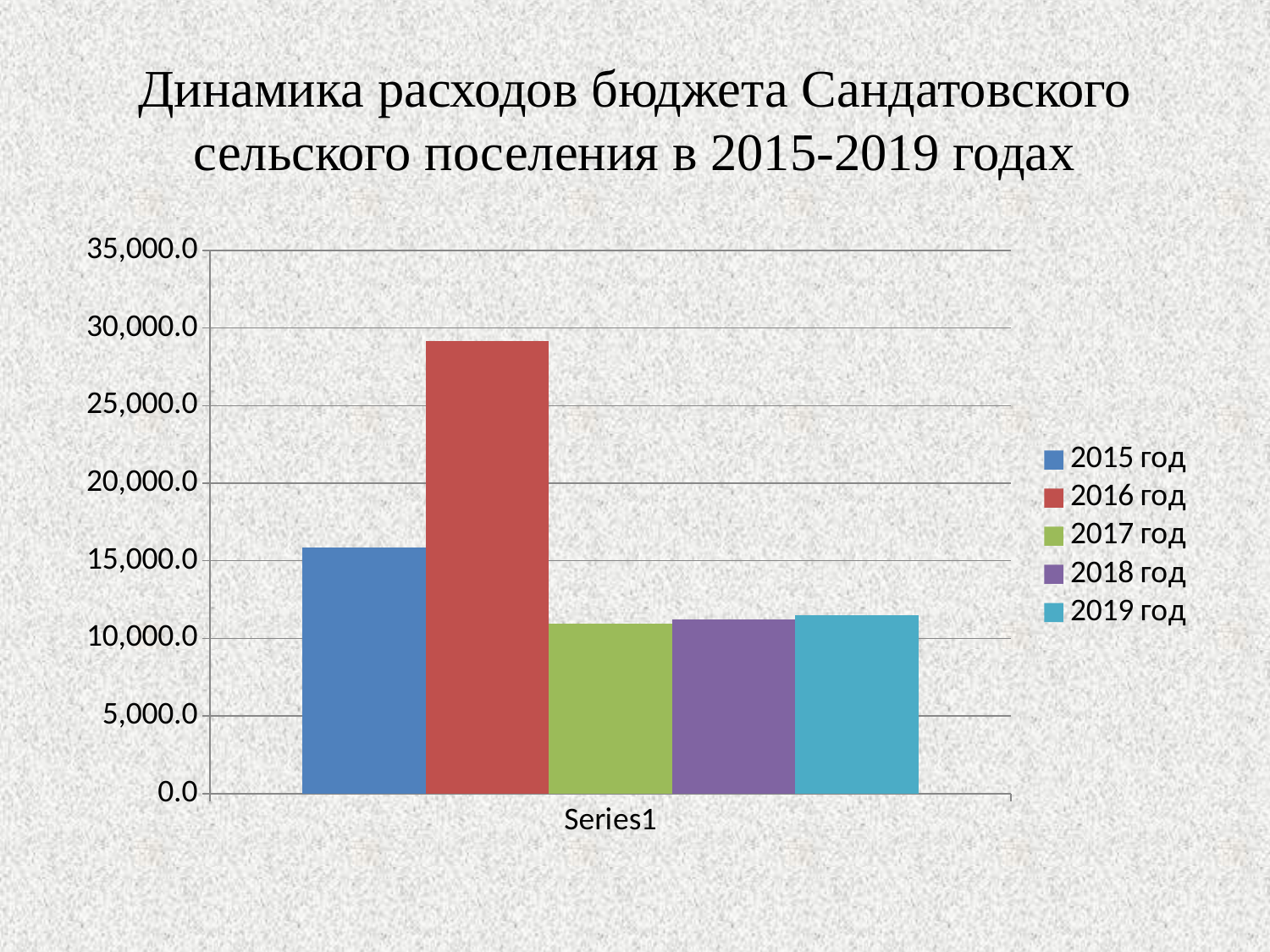
Which year has the highest bar? 2016 год What kind of chart is shown on the slide? bar chart Which is larger, the value for 2015 год or the value for 2016 год? 2016 год Which is larger, the value for 2015 год or the value for 2019 год? 2015 год Is the value for 2016 год greater or less than 25,000.0? greater Is the value for 2017 год greater or less than 15,000.0? less How many series does the legend list? 5 Is the value for 2015 год greater or less than 15,000.0? greater What colour is the bar for 2016 год? red What is the title of the chart on the slide? Динамика расходов бюджета Сандатовского сельского поселения в 2015-2019 годах